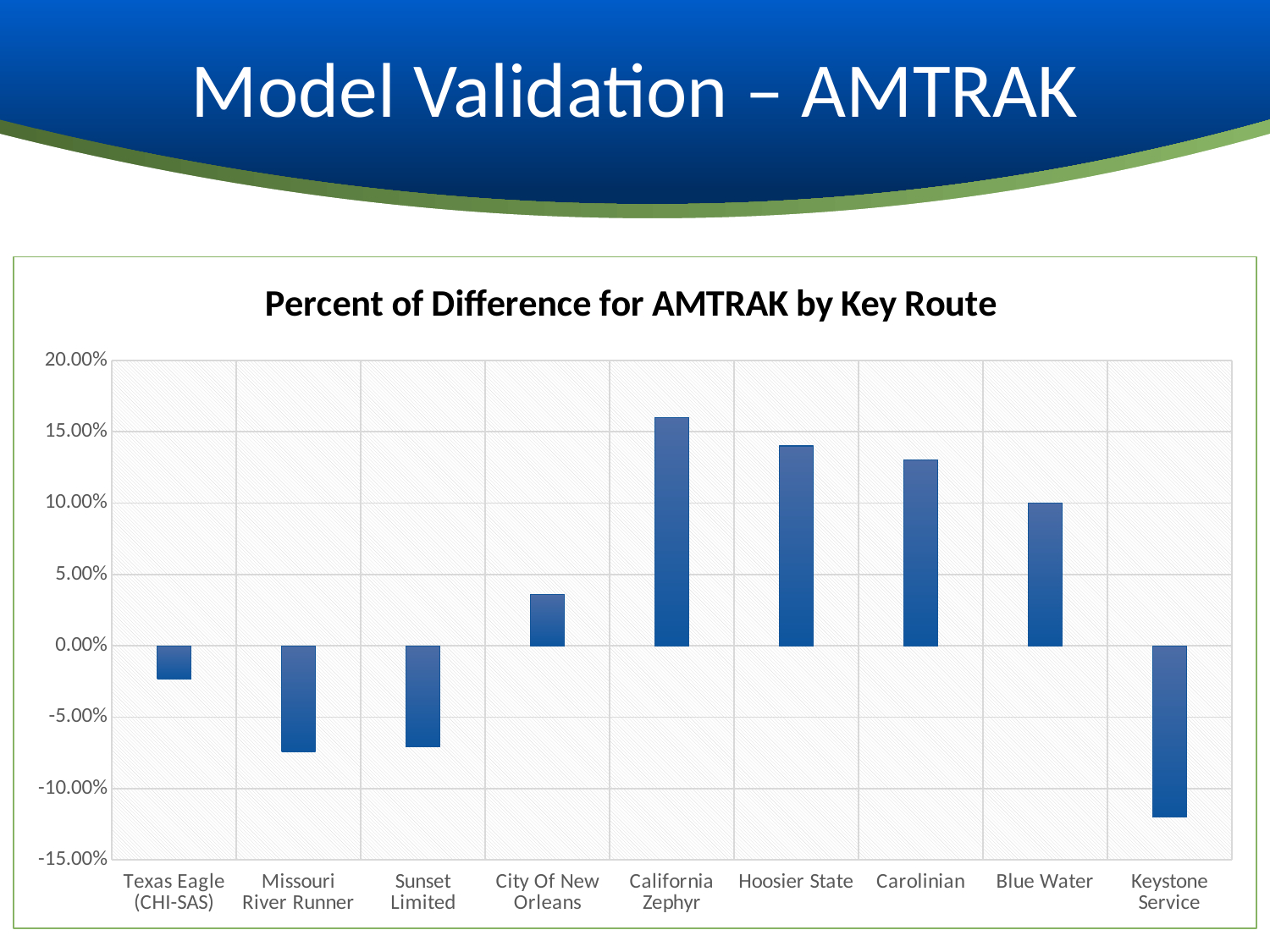
Which route has the lowest percent of difference? Keystone Service How many routes are plotted on the chart? 9 Is the value for Keystone Service greater or less than -10.00%? less Is the value for Texas Eagle (CHI-SAS) greater or less than -5.00%? greater Which has a larger percent of difference, Carolinian or Blue Water? Carolinian Which has a larger percent of difference, California Zephyr or Hoosier State? California Zephyr Is the value for Carolinian greater or less than 10.00%? greater What is the title of the chart? Percent of Difference for AMTRAK by Key Route Which route has the highest percent of difference? California Zephyr What type of chart is shown on the slide? bar chart